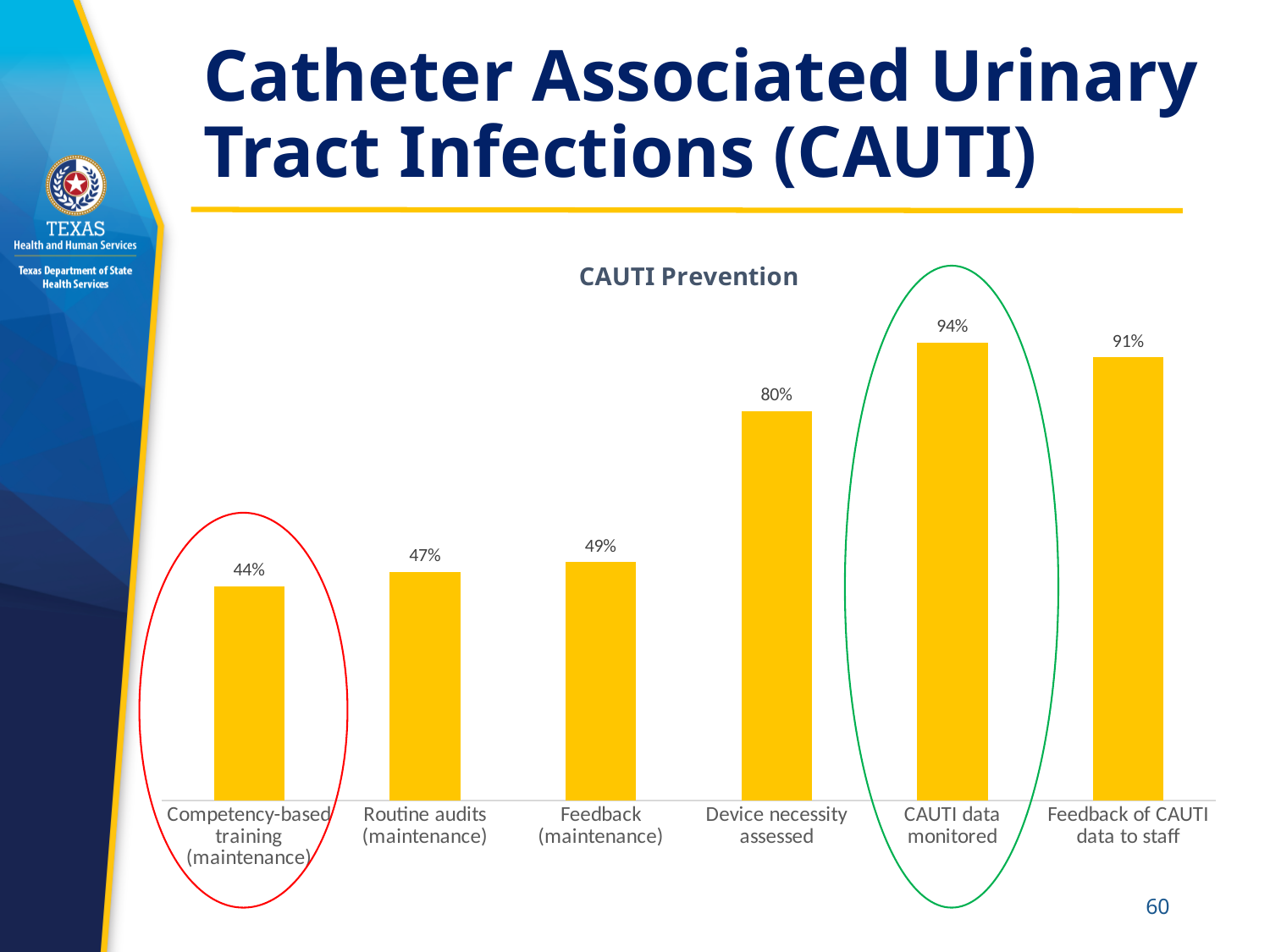
How many categories are shown in the chart? 6 What is the title of the chart? CAUTI Prevention Which category has the highest value? CAUTI data monitored Which category is circled in red? Competency-based training (maintenance) What is the difference between Feedback (maintenance) and Routine audits (maintenance)? 2% Which is larger, Device necessity assessed or Feedback (maintenance)? Device necessity assessed What is the value for Routine audits (maintenance)? 47% What kind of chart is this? Bar chart Which category has the lowest value? Competency-based training (maintenance) What is the value for Device necessity assessed? 80% What is the difference between CAUTI data monitored and Competency-based training (maintenance)? 50% What is the value for Feedback of CAUTI data to staff? 91%